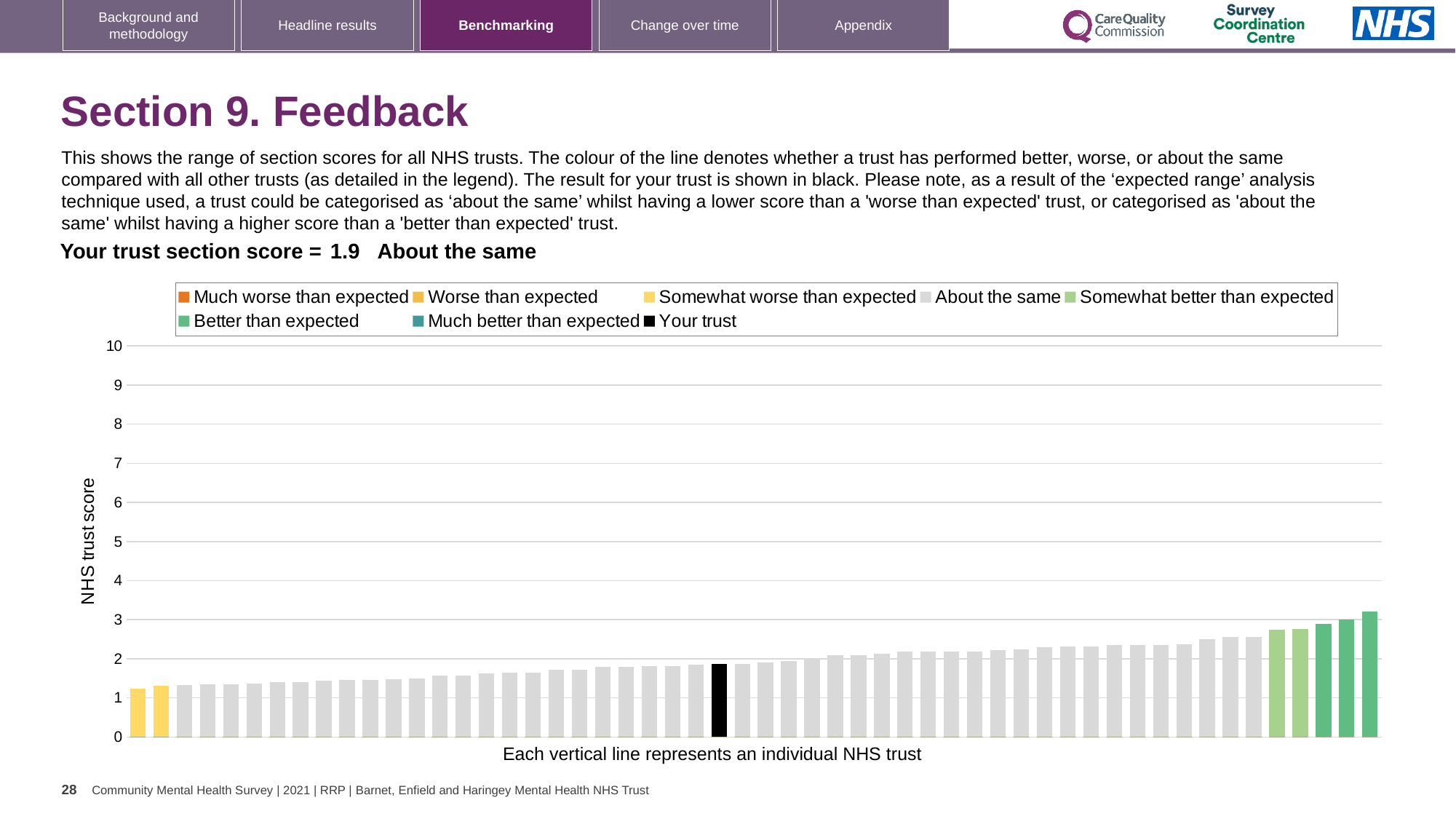
What is the title of the vertical axis? NHS trust score What colour is used for the bar representing your trust? black How many entries does the chart legend list? 8 How many bars are coloured yellow (Somewhat worse than expected)? 2 Is the value of the black bar (your trust) greater or less than 2? less Which benchmarking category is your trust placed in for Section 9. Feedback? About the same How many bars are coloured dark green (Better than expected)? 3 Is the value of the tallest bar in the chart greater or less than 3? greater What is the section score for your trust shown on the slide? 1.9 Do the bar values rise or fall from left to right along the x axis? rise Is the value of the shortest bar in the chart greater or less than 1? greater What kind of chart is shown on the slide? bar chart